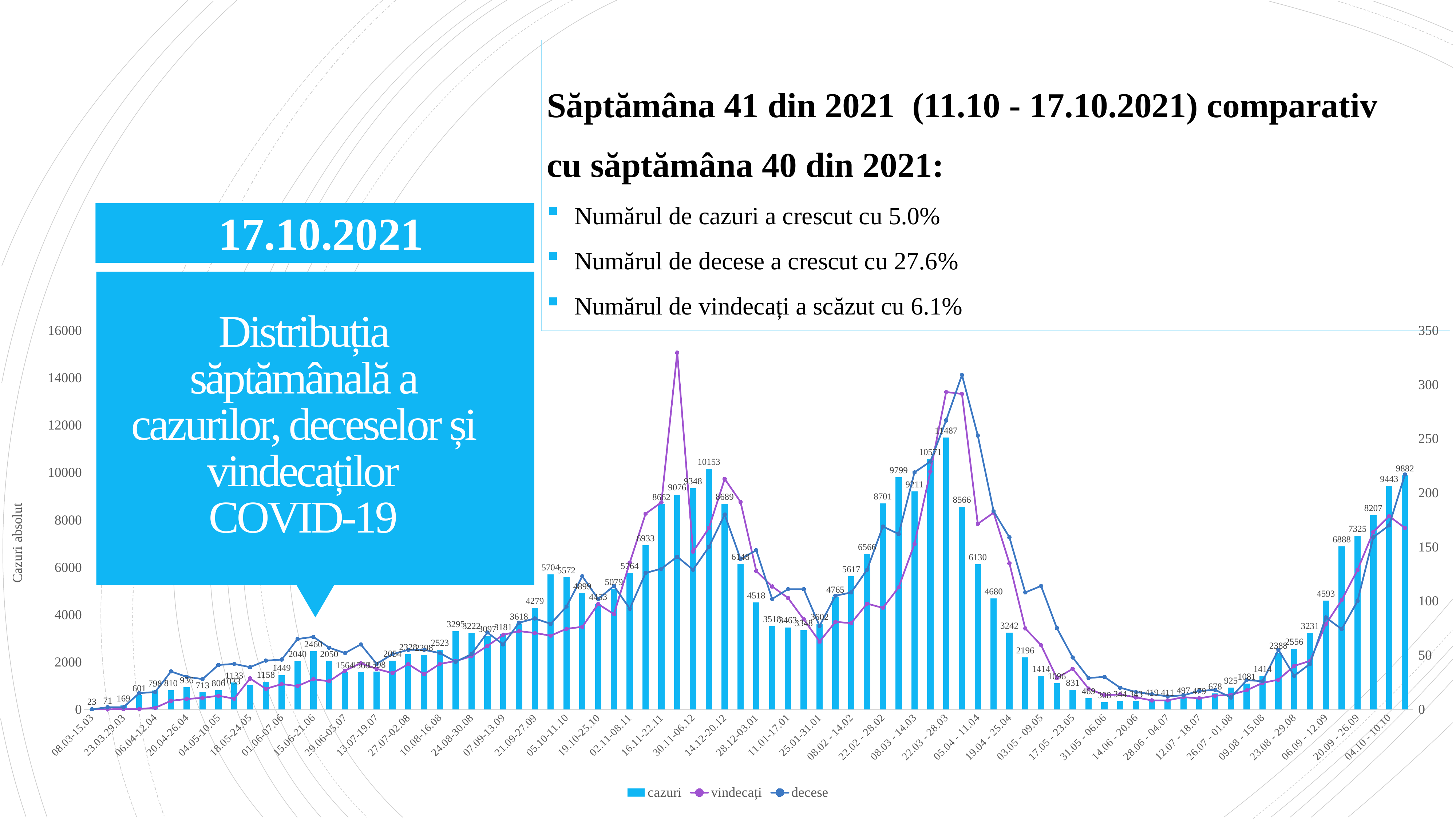
Is the peak value of the vindecați line greater or less than 14000 on the left axis? greater How many series does the chart legend list? 3 What kind of chart is shown on the slide? Combined bar and line chart What is the value of the cazuri bar for the week 04.10-10.10? 9443 What is the difference between the cazuri bars labelled 11487 and 10153? 1334 What is the lowest value shown for the cazuri bars? 23 What is the highest value shown for the cazuri bars? 11487 Which is larger: the cazuri bar labelled 11487 or the one labelled 10153? 11487 Is the peak value of the decese line greater or less than 250 on the right axis? greater Which series are listed in the chart legend? cazuri, vindecați, decese What is the value of the last (most recent) cazuri bar on the chart? 9882 What is the value of the cazuri bar for the week 08.03-15.03? 23